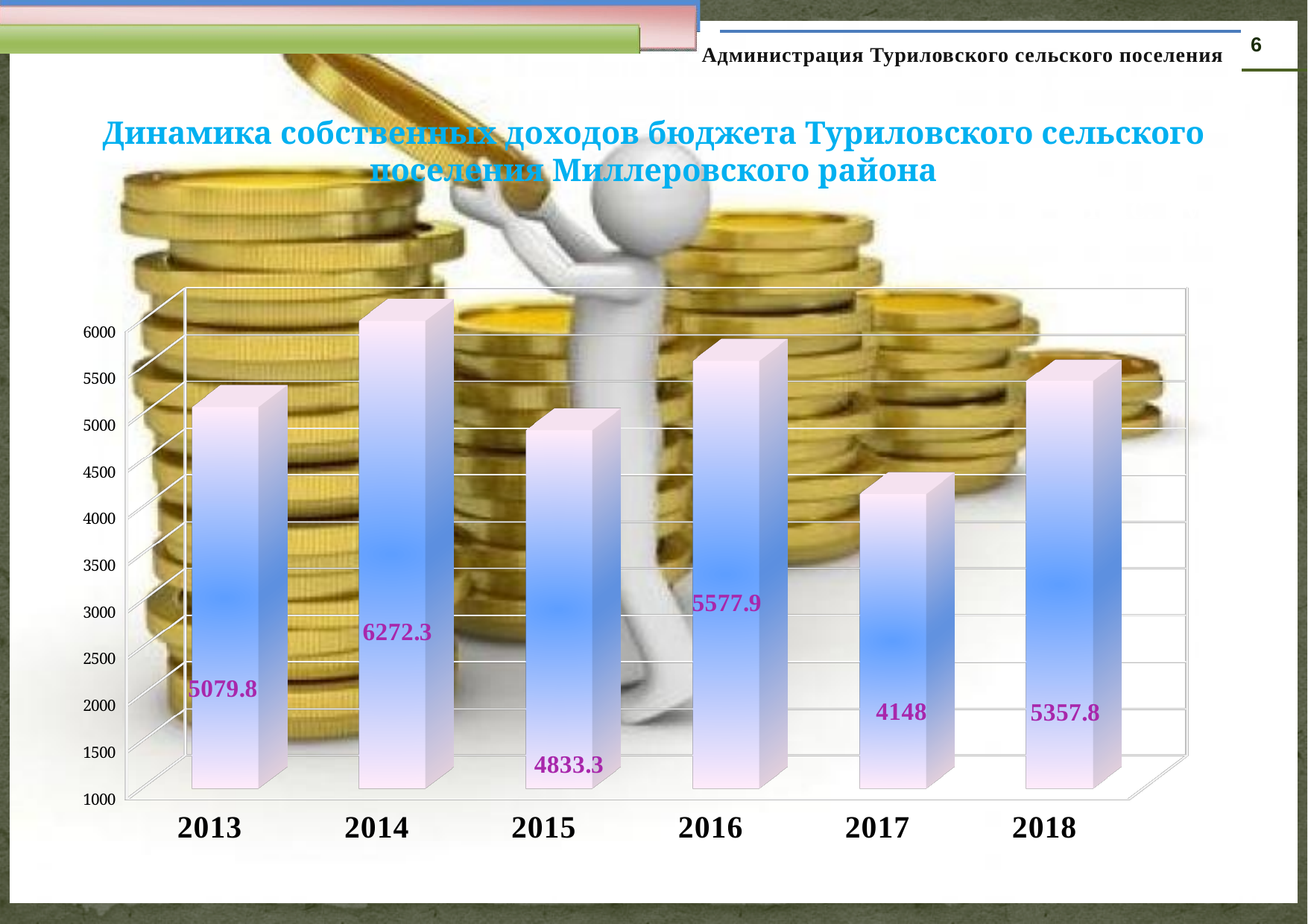
How many years are shown on the x axis? 6 Is the value for 2015 greater or less than 5000? less What is the value for 2014? 6272.3 What is the difference between the values for 2016 and 2015? 744.6 What is the value for 2018? 5357.8 Does the value rise or fall from 2017 to 2018? rise Which year has the lowest value? 2017 What is the difference between the values for 2014 and 2017? 2124.3 What is the value for 2017? 4148 Which is larger, the value for 2013 or the value for 2018? 2018 Which year has the highest value? 2014 What kind of chart is shown on the slide? bar chart